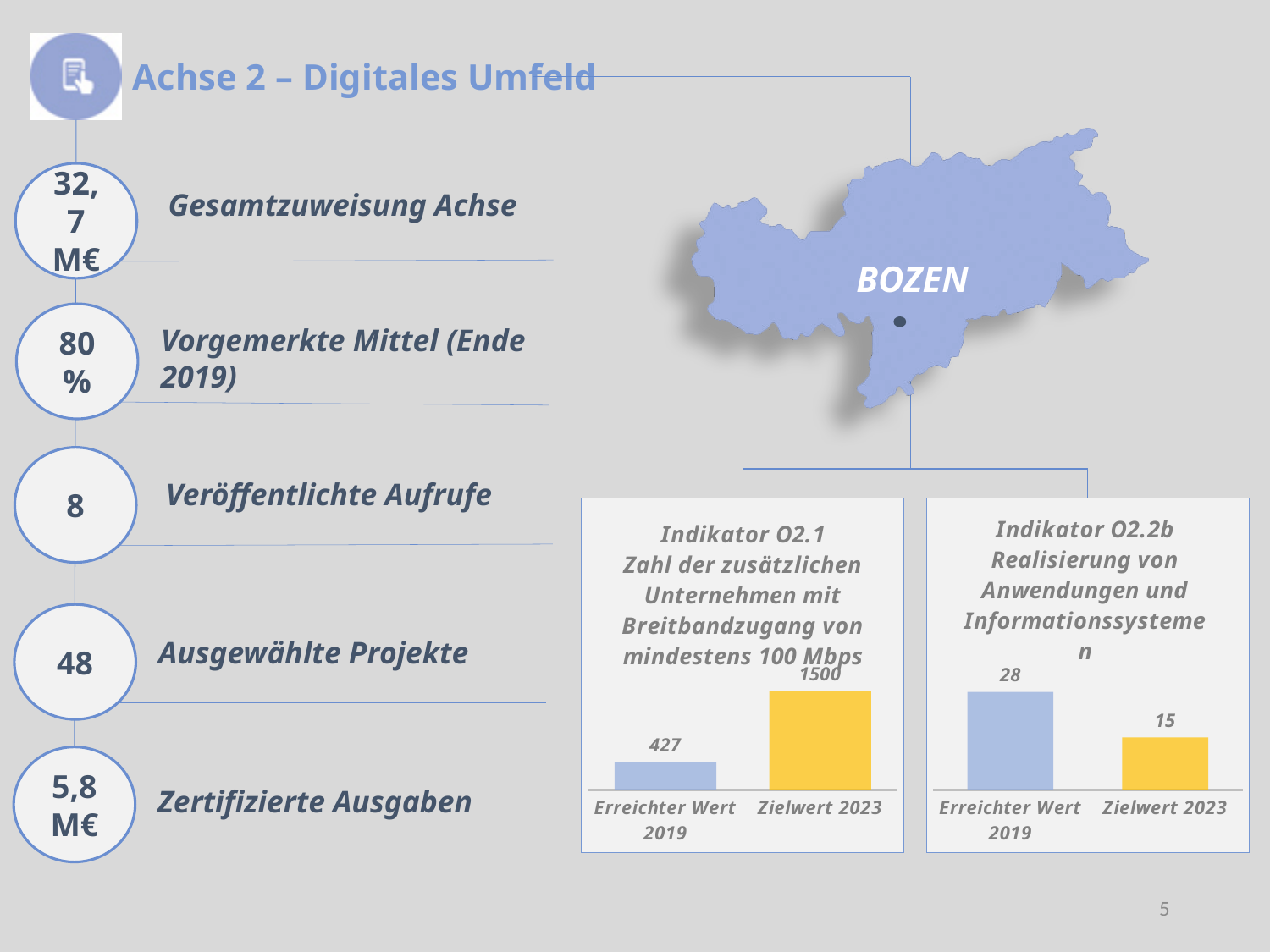
How many categories does the Indikator O2.1 chart show? 2 In the Indikator O2.2b chart, what is the value for Erreichter Wert 2019? 28 In the Indikator O2.1 chart, what colour is the Zielwert 2023 bar? yellow In the Indikator O2.1 chart, what is the value for Erreichter Wert 2019? 427 In the Indikator O2.2b chart, which category has the lower value? Zielwert 2023 In the Indikator O2.1 chart, what is the value for Zielwert 2023? 1500 What kind of chart is the Indikator O2.2b chart? bar chart In the Indikator O2.1 chart, which category has the higher value? Zielwert 2023 In the Indikator O2.2b chart, is Erreichter Wert 2019 larger or smaller than Zielwert 2023? larger In the Indikator O2.2b chart, what is the difference between Erreichter Wert 2019 and Zielwert 2023? 13 In the Indikator O2.1 chart, what is the difference between Zielwert 2023 and Erreichter Wert 2019? 1073 In the Indikator O2.2b chart, what is the value for Zielwert 2023? 15